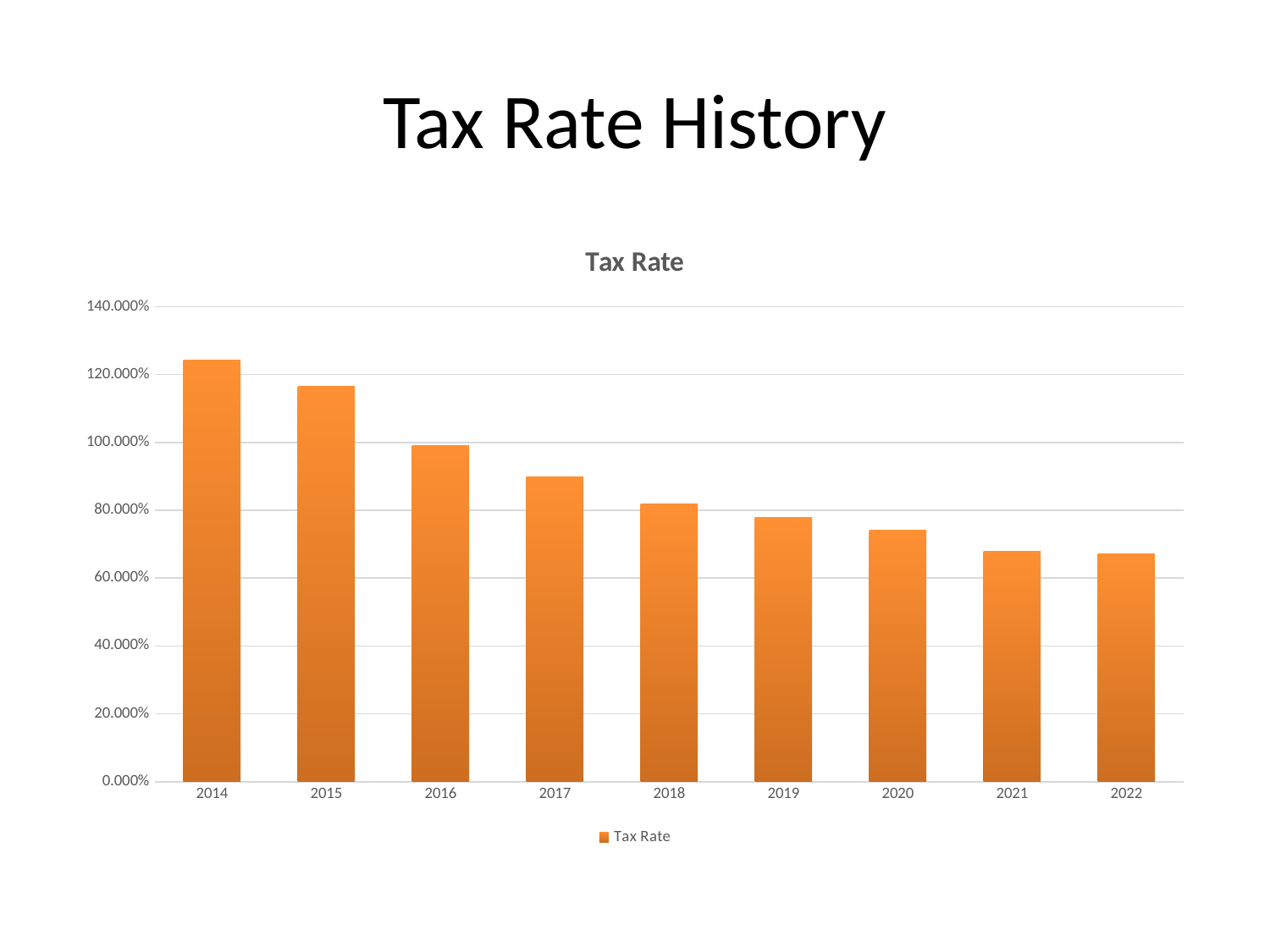
What is the title of the chart? Tax Rate Which year has the larger tax rate, 2016 or 2019? 2016 Is the tax rate for 2020 greater or less than 80.000%? less How many years are shown on the x axis of the chart? 9 Is the tax rate for 2014 greater or less than 120.000%? greater What type of chart is shown on the slide? bar chart Which year has the highest tax rate? 2014 Do the tax rate values rise or fall from 2014 to 2022? fall Is the tax rate for 2015 greater or less than 100.000%? greater How many series does the legend list? 1